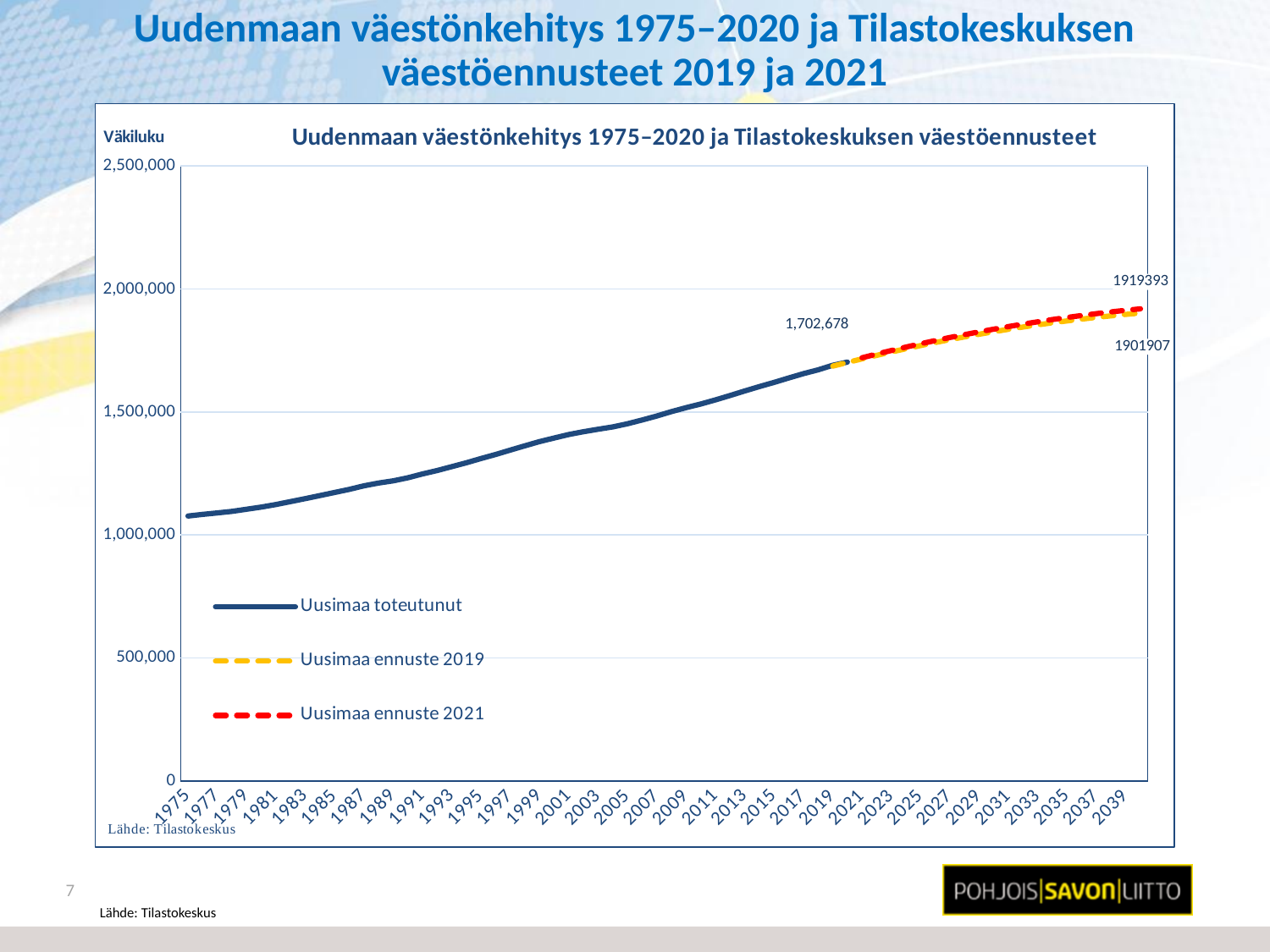
What is the difference between the two forecast end values labelled 1919393 and 1901907? 17486 What is the label on the vertical axis of the chart? Väkiluku What kind of chart is shown on the slide? line chart What is the difference between the labelled 2020 value 1,702,678 and the higher forecast end value 1919393? 216,715 What is the lower of the two values labelled at the right end of the forecast lines? 1901907 What is the highest value labelled on the chart at the right end of the forecast lines? 1919393 Is the value for Uusimaa toteutunut in 1975 greater or less than 1,000,000? greater Is the value for Uusimaa toteutunut in 2005 greater or less than 1,500,000? less Does the Uusimaa toteutunut line rise or fall from 1975 to 2020? rise Which series is drawn with a red dashed line? Uusimaa ennuste 2021 How many series does the chart legend list? 3 What value is labelled at the end of the Uusimaa toteutunut series in 2020? 1,702,678